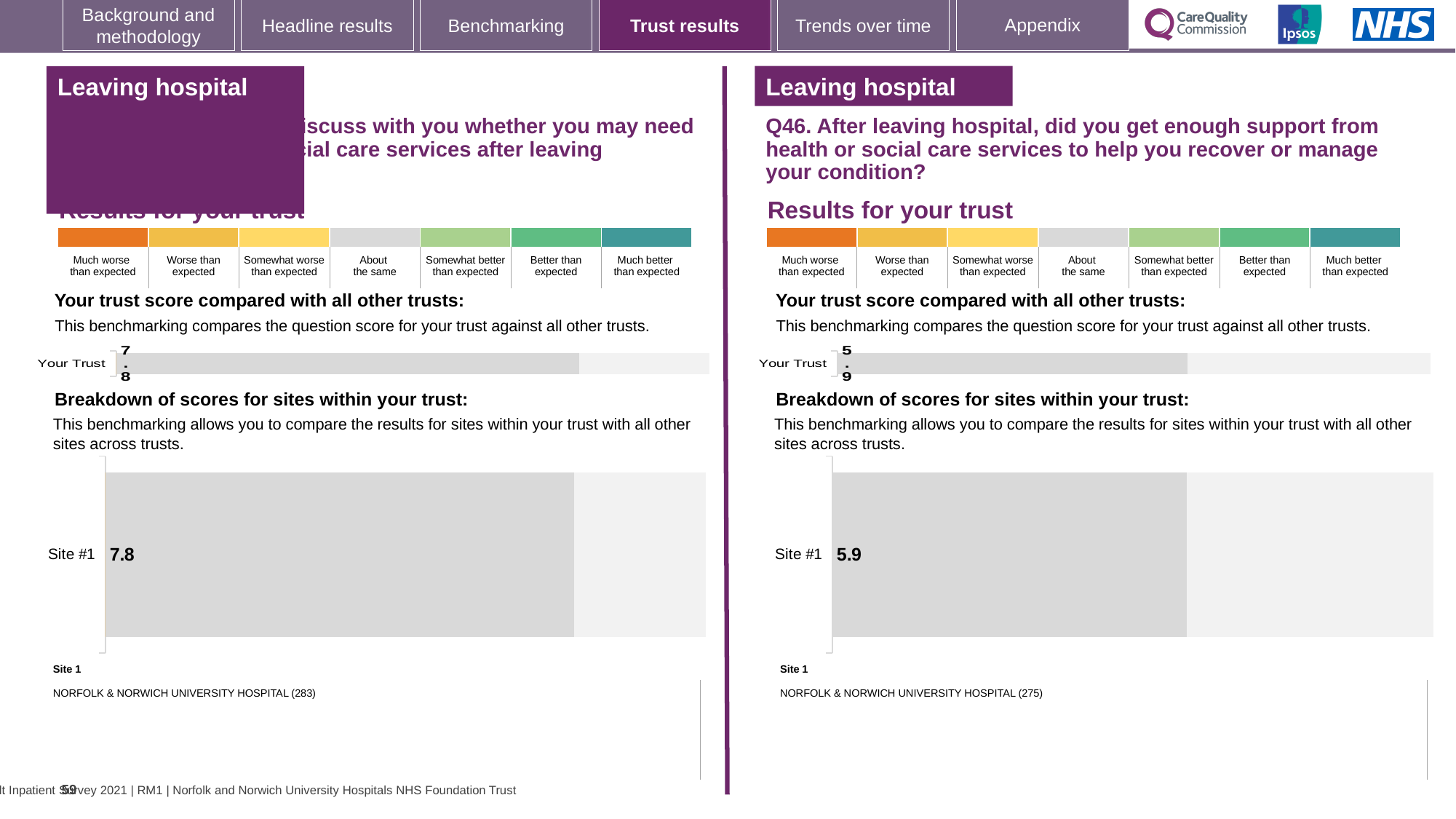
On the right half of the slide (Q46), what is the score shown for Site #1? 5.9 How many sites are shown in the site breakdown chart on the left half of the slide? 1 On the left half of the slide, what is the score shown for Site #1? 7.8 What type of chart is used to show the Site #1 score on the right half of the slide (Q46)? Bar chart What is the difference between the Your Trust score on the left half of the slide and the Your Trust score on the right half (Q46)? 1.9 On the left half of the slide, which site name is listed under Site 1? NORFOLK & NORWICH UNIVERSITY HOSPITAL (283) On the right half of the slide (Q46), which site name is listed under Site 1? NORFOLK & NORWICH UNIVERSITY HOSPITAL (275) Which is larger: the Site #1 score on the left half of the slide or the Site #1 score on the right half (Q46)? Left half (7.8) How many sites are shown in the site breakdown chart on the right half of the slide (Q46)? 1 On the left half of the slide, what is the score shown for Your Trust? 7.8 What is the difference between the Site #1 score on the left half of the slide and the Site #1 score on the right half (Q46)? 1.9 On the right half of the slide (Q46), what is the score shown for Your Trust? 5.9